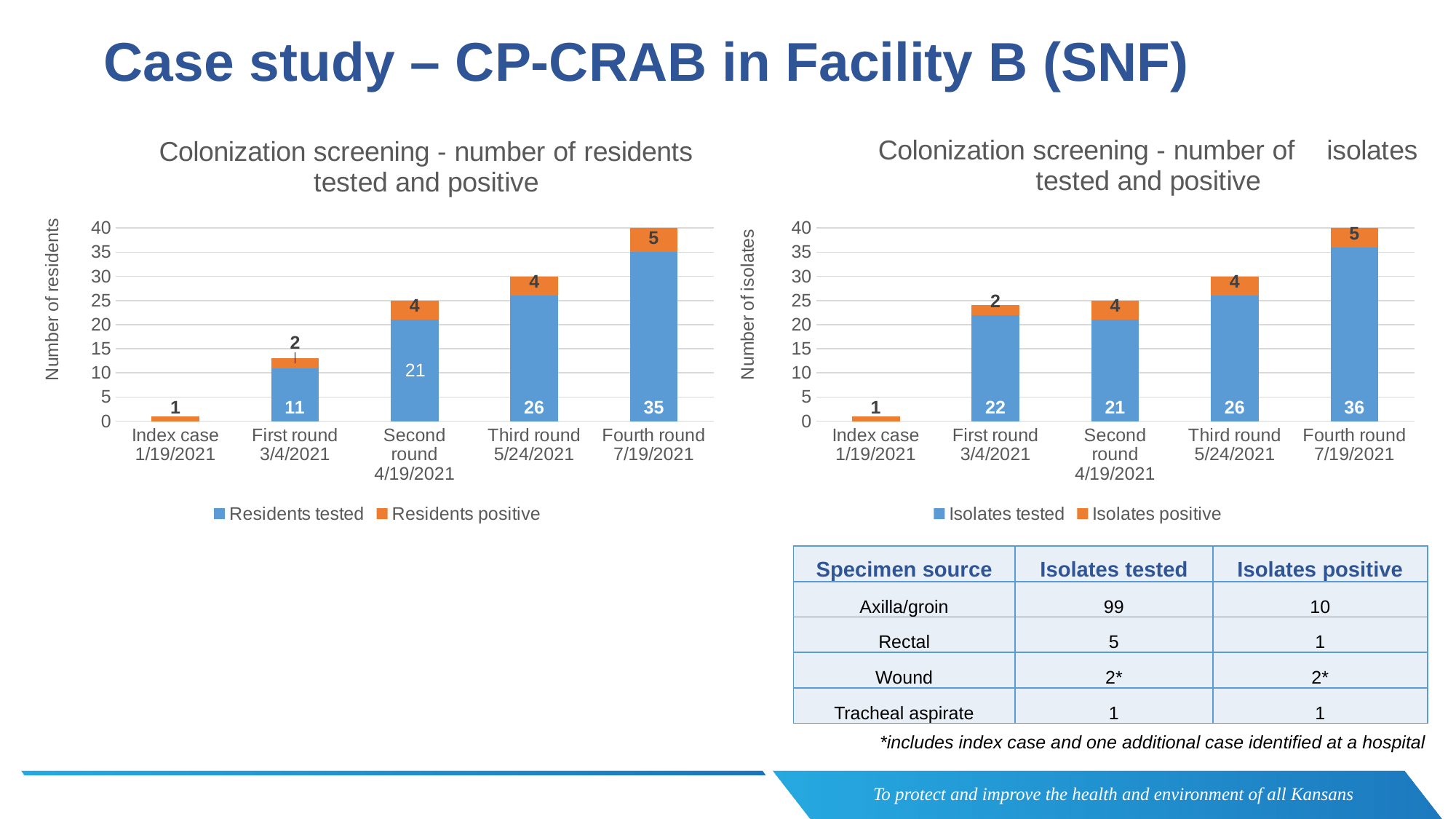
What kind of chart is the left chart (number of residents tested and positive)? Stacked bar chart In the right chart (number of isolates tested and positive), which round had the highest number of isolates tested? Fourth round 7/19/2021 In the right chart (number of isolates tested and positive), which is larger: isolates tested in the Second round or in the Third round? Third round In the right chart (number of isolates tested and positive), what is the total height of the stacked bar for the First round 3/4/2021? 24 In the left chart (number of residents tested and positive), how many categories are shown on the x axis? 5 In the left chart (number of residents tested and positive), how many residents were positive in the Second round 4/19/2021? 4 In the left chart (number of residents tested and positive), do the residents tested values rise or fall from the First round to the Fourth round? Rise How many series does the legend of the right chart (number of isolates tested and positive) list? 2 In the right chart (number of isolates tested and positive), how many isolates were tested in the First round 3/4/2021? 22 In the left chart (number of residents tested and positive), how many residents were tested in the Fourth round 7/19/2021? 35 In the left chart (number of residents tested and positive), what is the difference between residents tested in the Fourth round and the Third round? 9 In the left chart (number of residents tested and positive), what is the total height of the stacked bar for the Third round 5/24/2021? 30